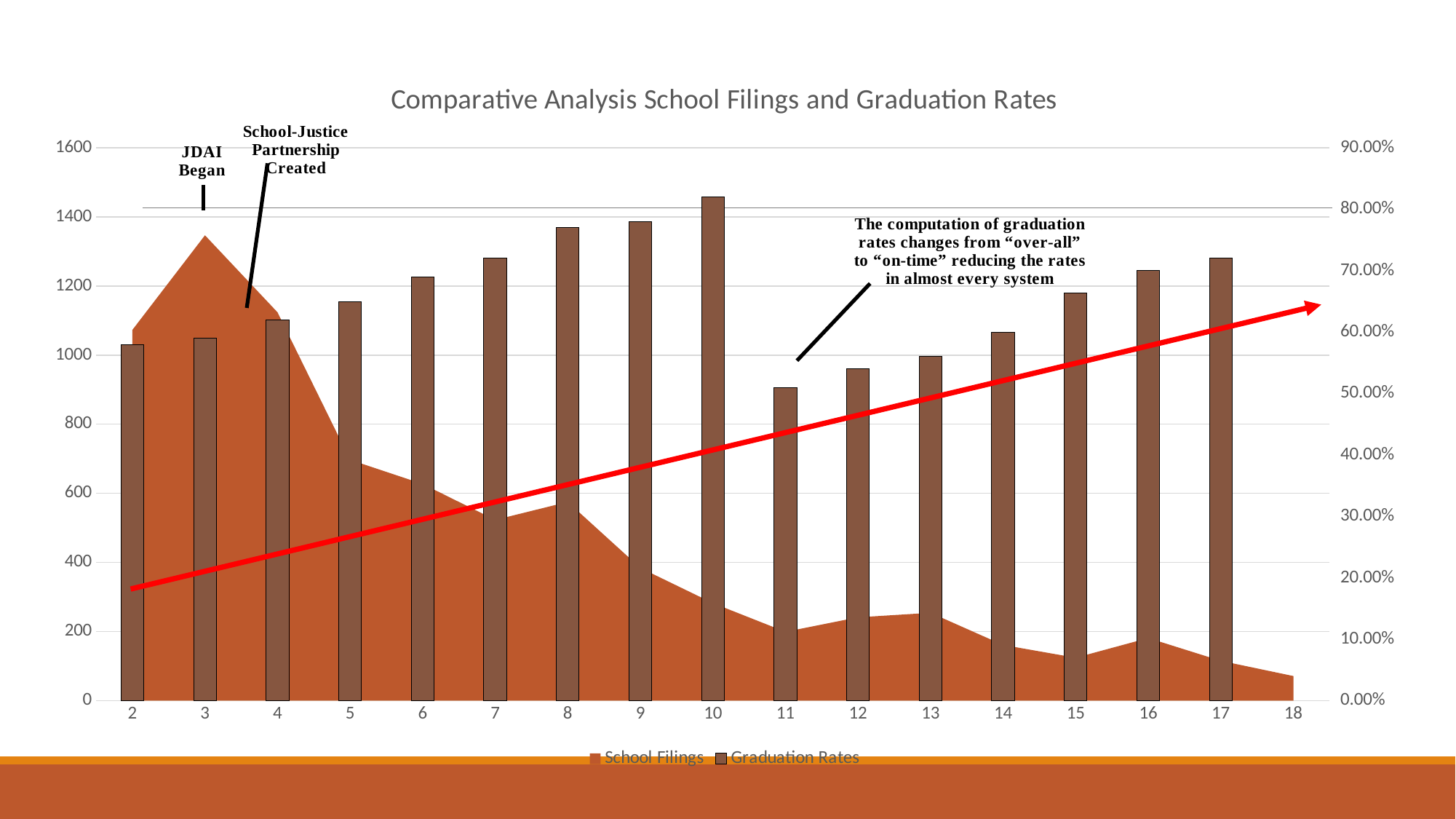
What is the title of the chart? Comparative Analysis School Filings and Graduation Rates What kind of chart is this? A combination chart with an area series and a bar series How many series does the legend list? 2 Is the School Filings value at category 18 greater or less than 200? less Is the Graduation Rates value at category 10 greater or less than 80.00%? greater Overall, do the School Filings values rise or fall from category 3 to category 18? fall Is the Graduation Rates value at category 11 greater or less than 60.00%? less Which x-axis category has the highest Graduation Rates bar? 10 Which is larger, the Graduation Rates value at category 10 or at category 11? 10 How many categories are shown on the x axis? 17 Which x-axis category has the lowest Graduation Rates bar? 11